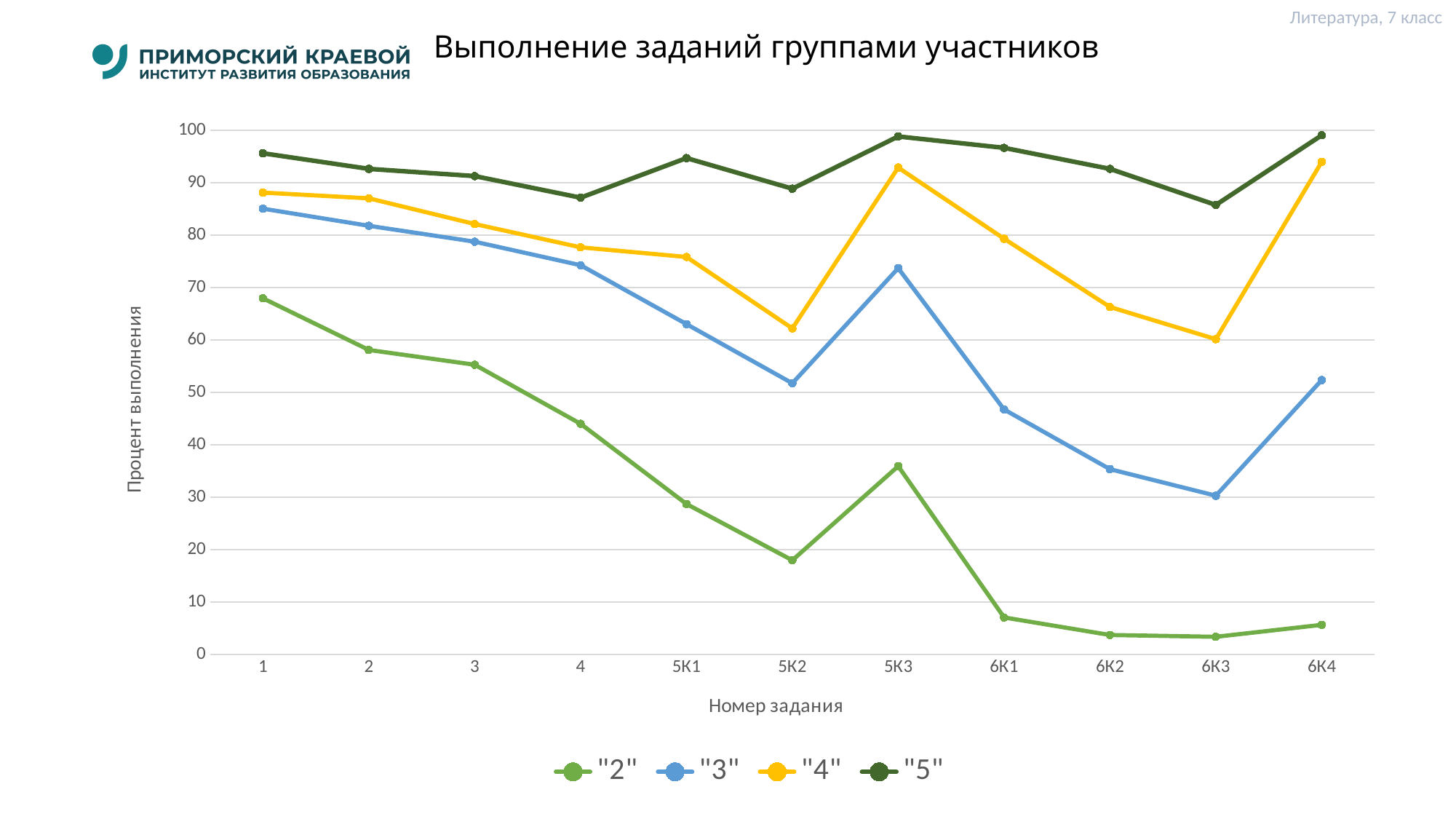
How many task categories are shown on the x axis? 11 Is the value of the "2" series for task 5К2 greater or less than 20? less Is the value of the "5" series for task 6К3 greater or less than 90? less For which task is the value of the "2" series highest? 1 For which task is the value of the "3" series lowest? 6К3 How many series does the legend list? 4 Is the value of the "2" series for task 4 greater or less than 40? greater What is the title of the x axis? Номер задания Does the "2" series rise or fall from task 1 to task 5К2? fall For task 6К4, which series has the larger value, "4" or "3"? "4" What kind of chart is shown on the slide? line chart